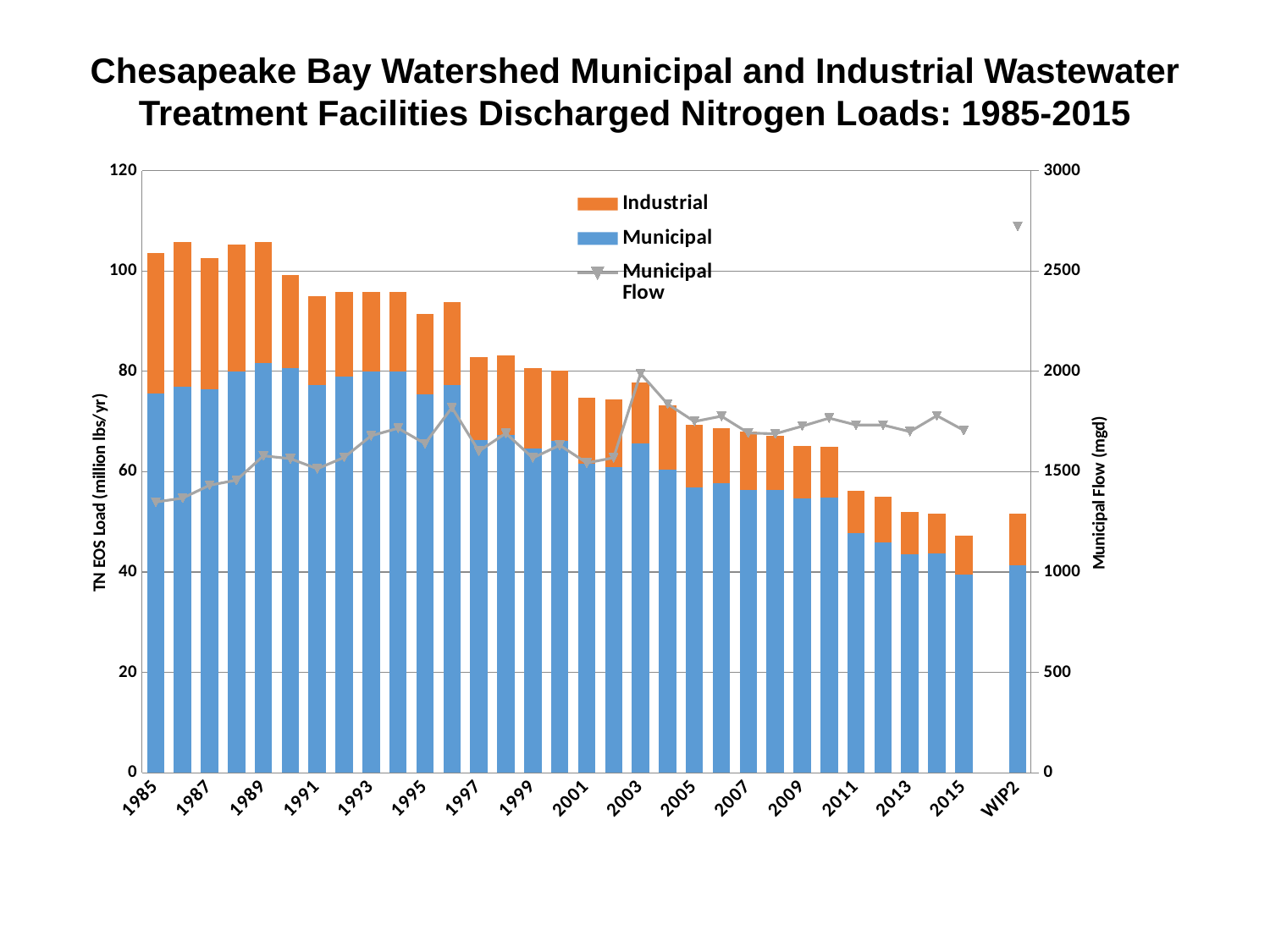
Is the total nitrogen load for 1985 greater or less than 100? greater Is the total nitrogen load for 2015 greater or less than 60? less Is the Municipal Flow value for WIP2 greater or less than 2500? greater What is the title of the left vertical axis? TN EOS Load (million lbs/yr) Which series is shown in orange? Industrial Which has the larger total nitrogen load, 1985 or 2015? 1985 How many series does the legend list? 3 What kind of chart is shown on the slide? combination bar and line chart Which year has the lowest total nitrogen load bar? 2015 Does the total nitrogen load generally rise or fall from 1985 to 2015? fall